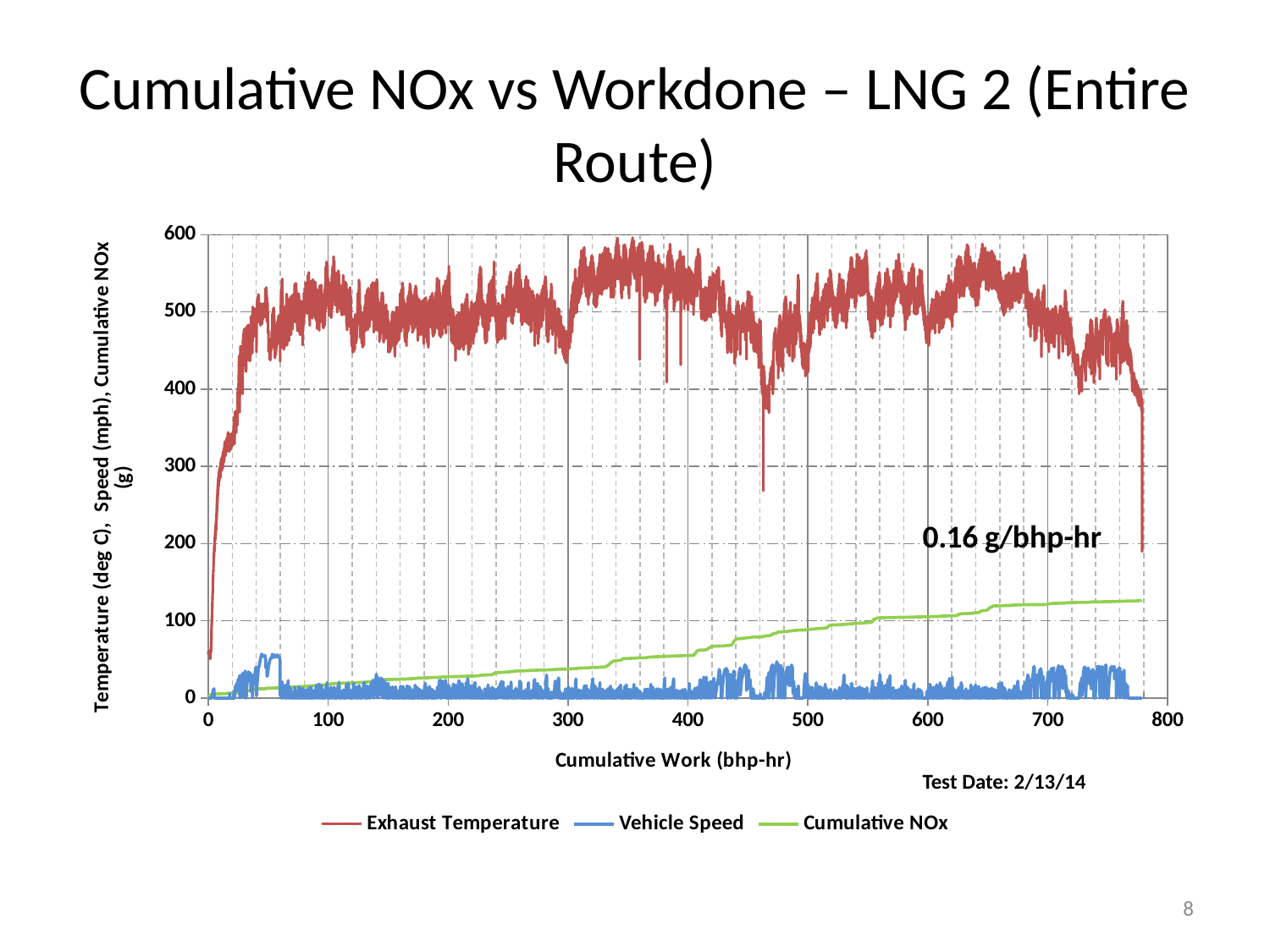
What is the label of the x axis? Cumulative Work (bhp-hr) What test date is shown on the slide? 2/13/14 Is the Exhaust Temperature value at 400 bhp-hr of cumulative work greater or less than 400? greater How many series does the legend list? 3 Which series has the highest values across most of the chart: Exhaust Temperature, Vehicle Speed, or Cumulative NOx? Exhaust Temperature At 600 bhp-hr of cumulative work, which is larger: the Cumulative NOx value or the Vehicle Speed value? Cumulative NOx What is the title of the chart on the slide? Cumulative NOx vs Workdone – LNG 2 (Entire Route) What kind of chart is shown on the slide? line chart Does the Cumulative NOx series rise or fall as cumulative work increases along the x axis? rise Is the Cumulative NOx value at the end of the route (near 780 bhp-hr) greater or less than 200? less Is the Vehicle Speed value at 300 bhp-hr of cumulative work greater or less than 100? less What NOx emission rate is annotated on the chart? 0.16 g/bhp-hr